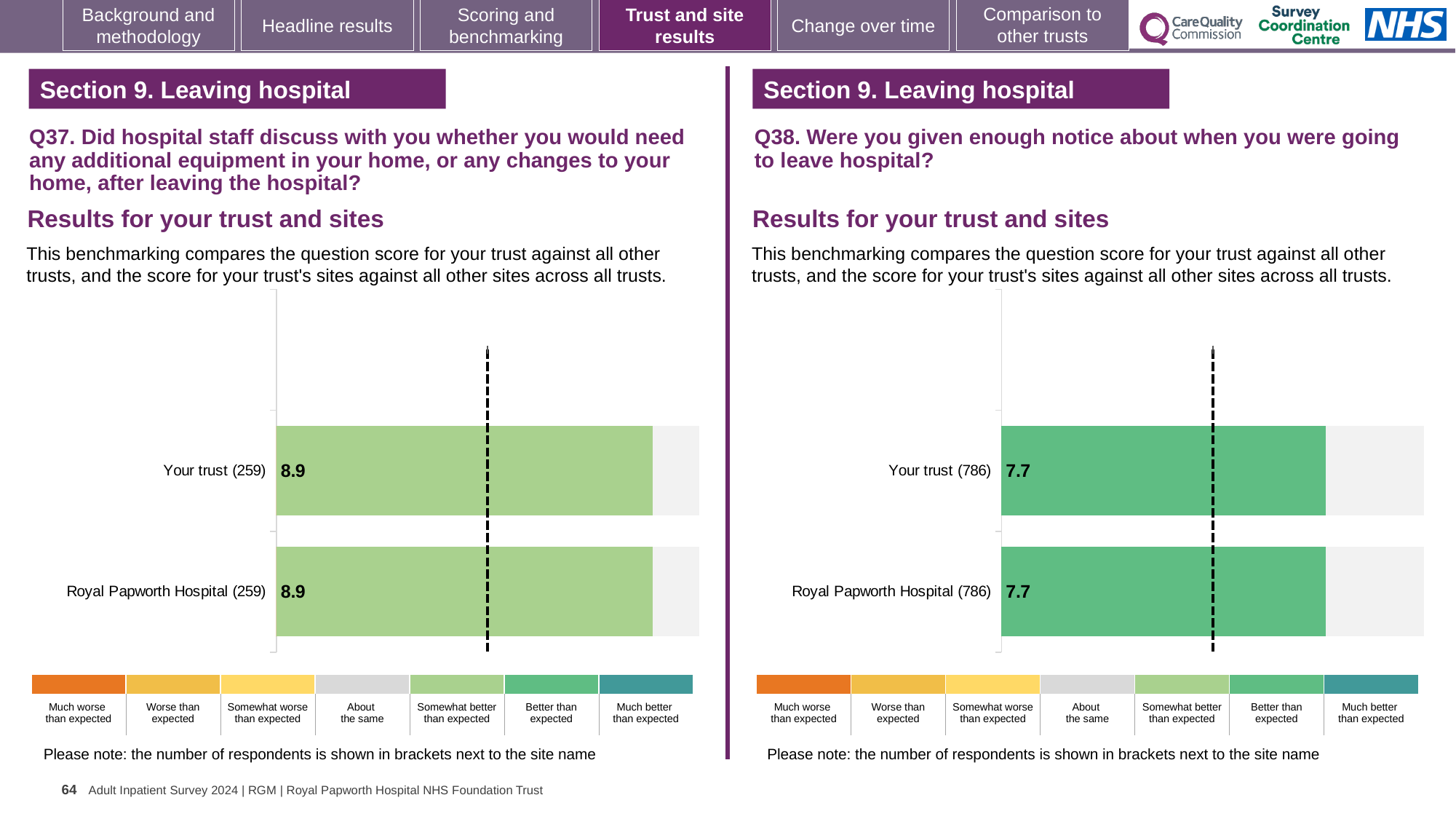
In the Q38 chart on the right, how many respondents are shown in brackets next to Royal Papworth Hospital? 786 In the Q38 chart on the right, what is the score for Your trust? 7.7 What is the difference between the Your trust score in the Q37 chart on the left and the Your trust score in the Q38 chart on the right? 1.2 In the Q38 chart on the right, what is the score for Royal Papworth Hospital? 7.7 In the Q37 chart on the left, what is the difference between the Your trust score and the Royal Papworth Hospital score? 0 In the Q37 chart on the left, what is the score for Royal Papworth Hospital? 8.9 In the Q37 chart on the left, how many respondents are shown in brackets next to Your trust? 259 In the Q37 chart on the left, what is the score for Your trust? 8.9 In the Q38 chart on the right, how many bars are plotted? 2 In the Q37 chart on the left, how many bars are plotted? 2 What kind of chart is the Q37 chart on the left? Bar chart Is the Your trust score in the Q37 chart on the left larger or smaller than the Your trust score in the Q38 chart on the right? Larger